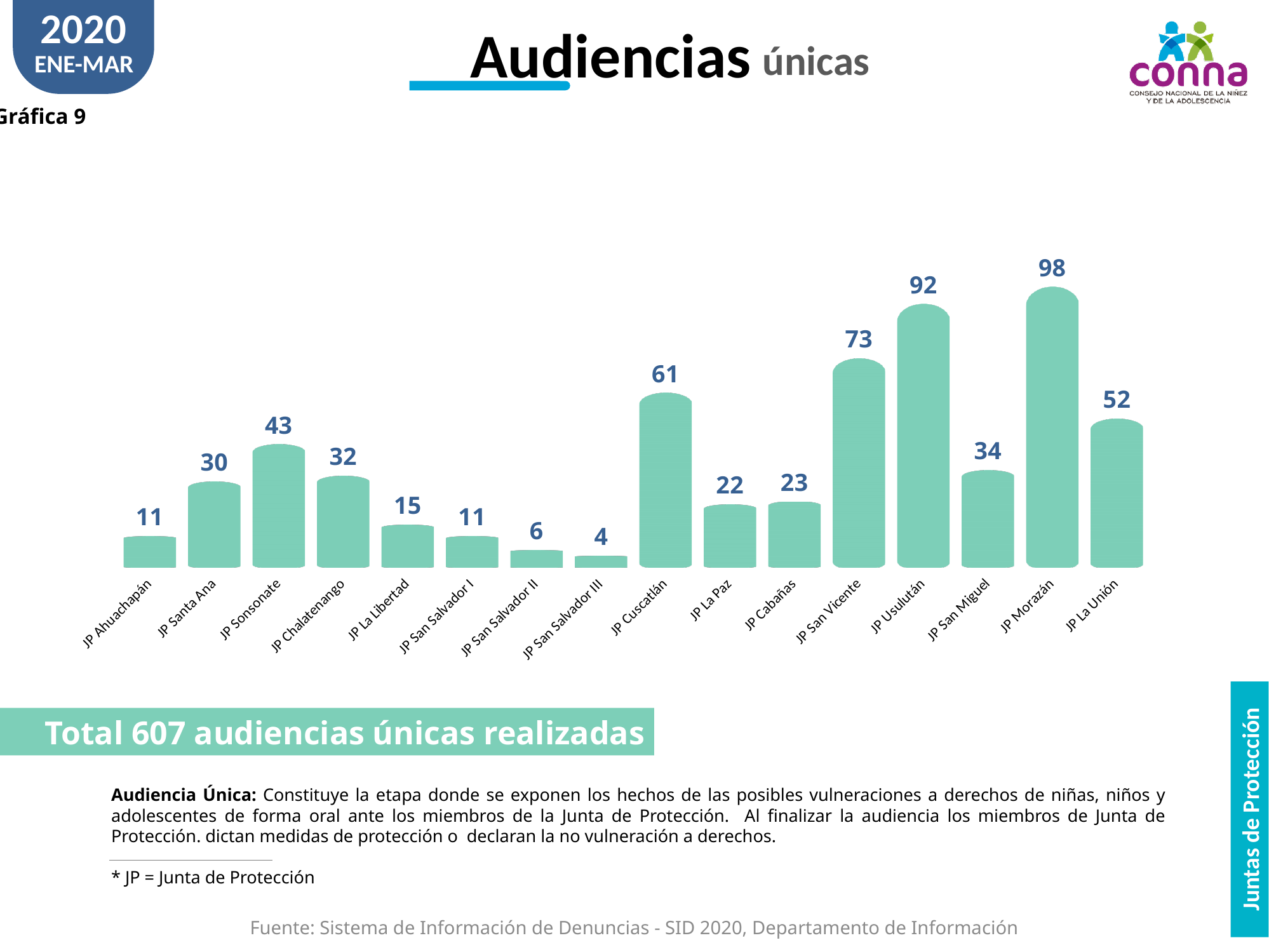
What total number of audiencias únicas does the slide report? 607 What is the difference between the values for JP Cabañas and JP La Paz? 1 What is the value for JP Chalatenango? 32 Which is larger, the value for JP La Unión or the value for JP San Miguel? JP La Unión Which category has the lowest value? JP San Salvador III What is the value for JP Cuscatlán? 61 How many categories are shown in the chart? 16 What is the value for JP Sonsonate? 43 What is the difference between the values for JP Usulután and JP San Vicente? 19 Which category has the highest value? JP Morazán What is the value for JP San Salvador III? 4 What kind of chart is shown on the slide? Bar chart